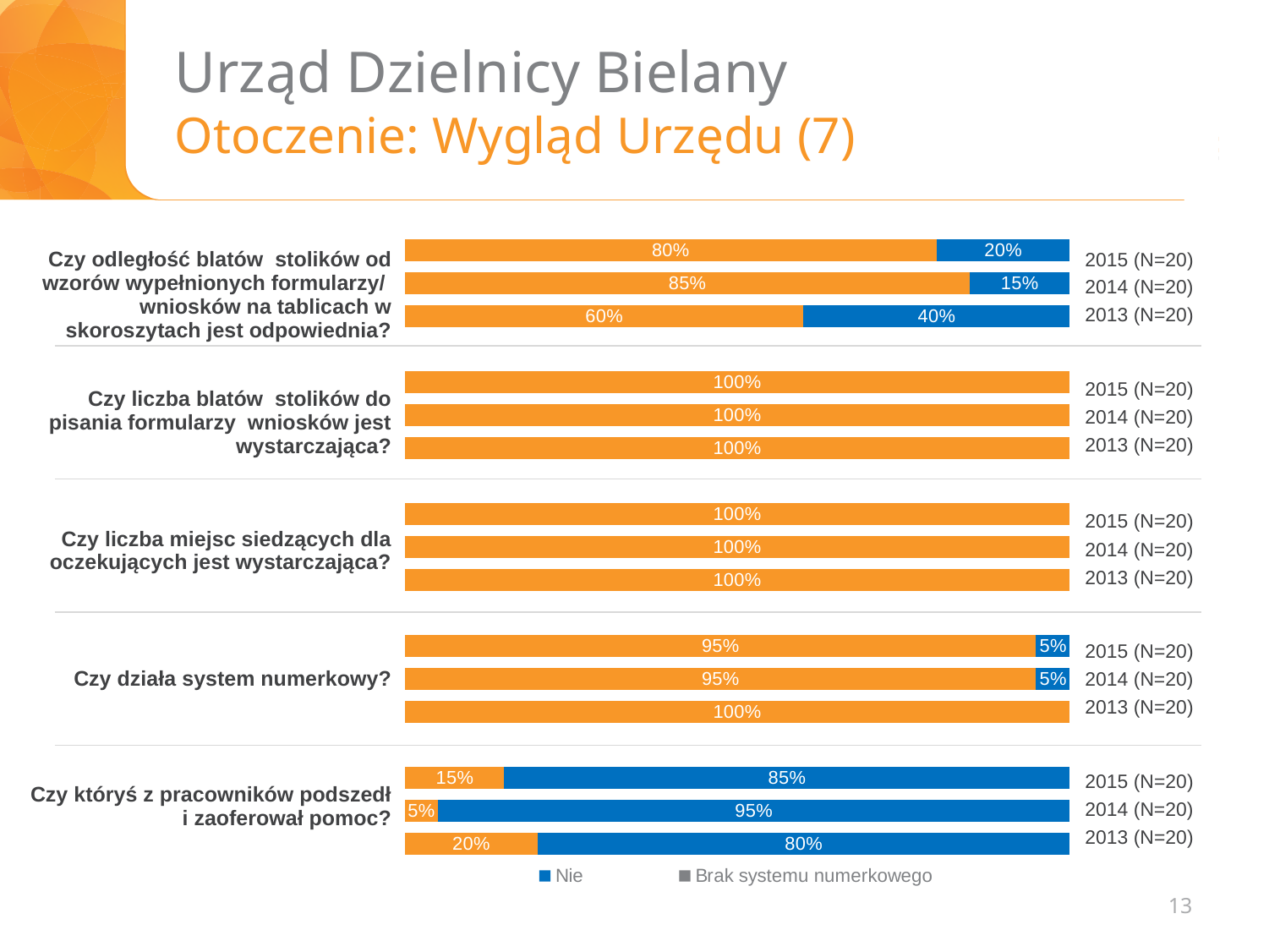
In the chart for "Czy odległość blatów stolików od wzorów wypełnionych formularzy/wniosków na tablicach w skoroszytach jest odpowiednia?", which year has the highest orange value? 2014 (N=20) In the chart for "Czy liczba blatów stolików do pisania formularzy wniosków jest wystarczająca?", what is the orange value for 2015 (N=20)? 100% In the chart for "Czy odległość blatów stolików od wzorów wypełnionych formularzy/wniosków na tablicach w skoroszytach jest odpowiednia?", what is the difference between the orange values for 2014 and 2013? 25 percentage points In the chart for "Czy któryś z pracowników podszedł i zaoferował pomoc?", which year has the lowest orange value? 2014 (N=20) In the chart for "Czy odległość blatów stolików od wzorów wypełnionych formularzy/wniosków na tablicach w skoroszytach jest odpowiednia?", what is the orange value for 2013 (N=20)? 60% In the chart for "Czy odległość blatów stolików od wzorów wypełnionych formularzy/wniosków na tablicach w skoroszytach jest odpowiednia?", what is the blue value for 2015 (N=20)? 20% How many years (bars) are shown for each question on the slide? 3 In the chart for "Czy odległość blatów stolików od wzorów wypełnionych formularzy/wniosków na tablicach w skoroszytach jest odpowiednia?", which year has the larger blue value, 2013 or 2015? 2013 In the chart for "Czy działa system numerkowy?", what is the blue value for 2015 (N=20)? 5% In the chart for "Czy któryś z pracowników podszedł i zaoferował pomoc?", what is the blue value for 2014 (N=20)? 95% What are the two legend entries shown at the bottom of the slide? Nie; Brak systemu numerkowego What kind of chart is used on the slide? Stacked bar chart